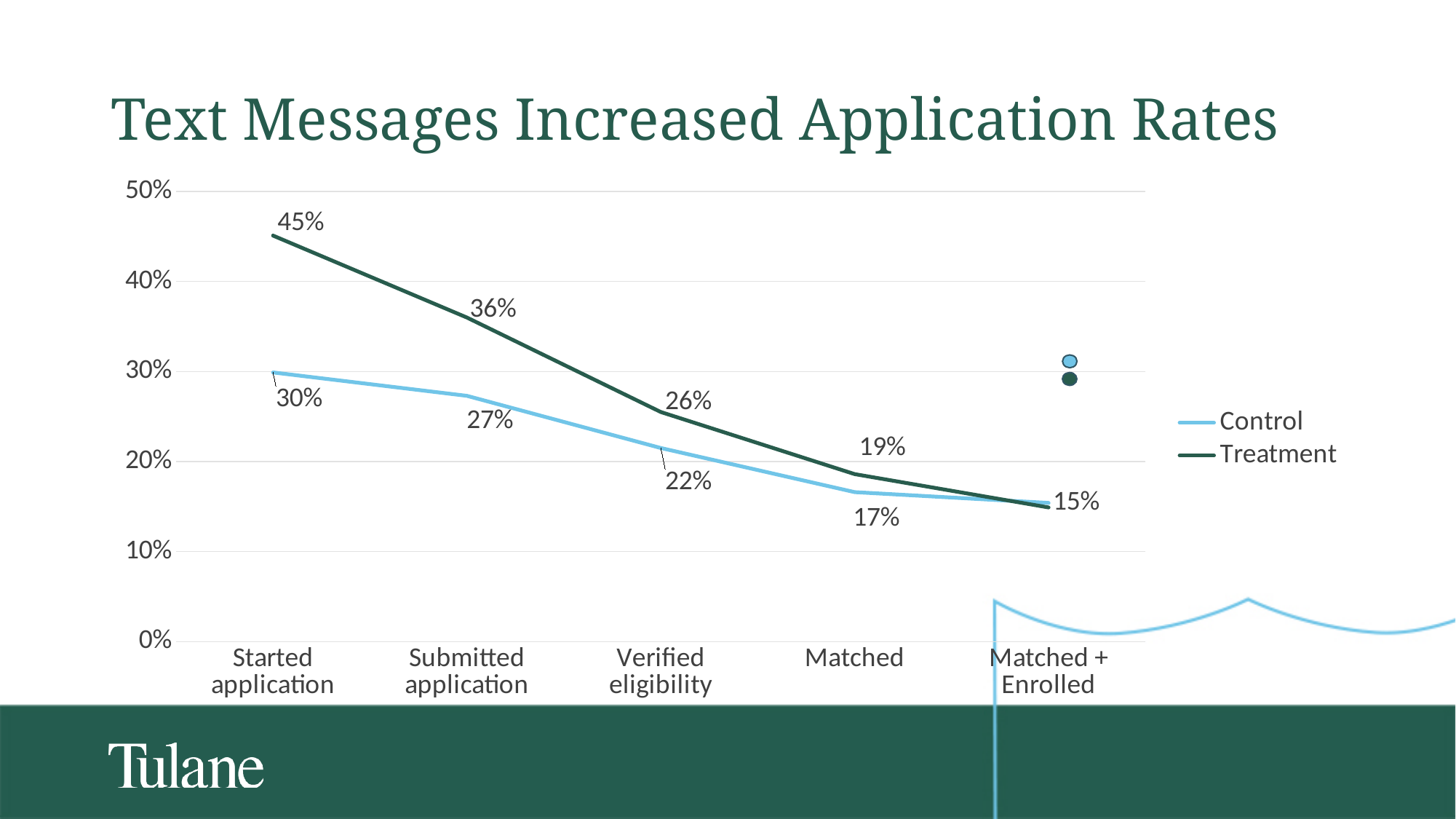
What is the Treatment value at Verified eligibility? 26% What is the difference between the Treatment and Control values at Started application? 15% What is the Control value at Submitted application? 27% At which stage is the Treatment value highest? Started application Which is larger at Submitted application, the Treatment value or the Control value? Treatment How many stages are shown on the x axis? 5 What is the Treatment value at Started application? 45% Is the Control value at Matched + Enrolled greater or less than 20%? less What is the Control value at Matched? 17% At which stage is the Control value lowest? Matched + Enrolled How many series does the legend list? 2 Do the Treatment values rise or fall from Started application to Matched + Enrolled? fall